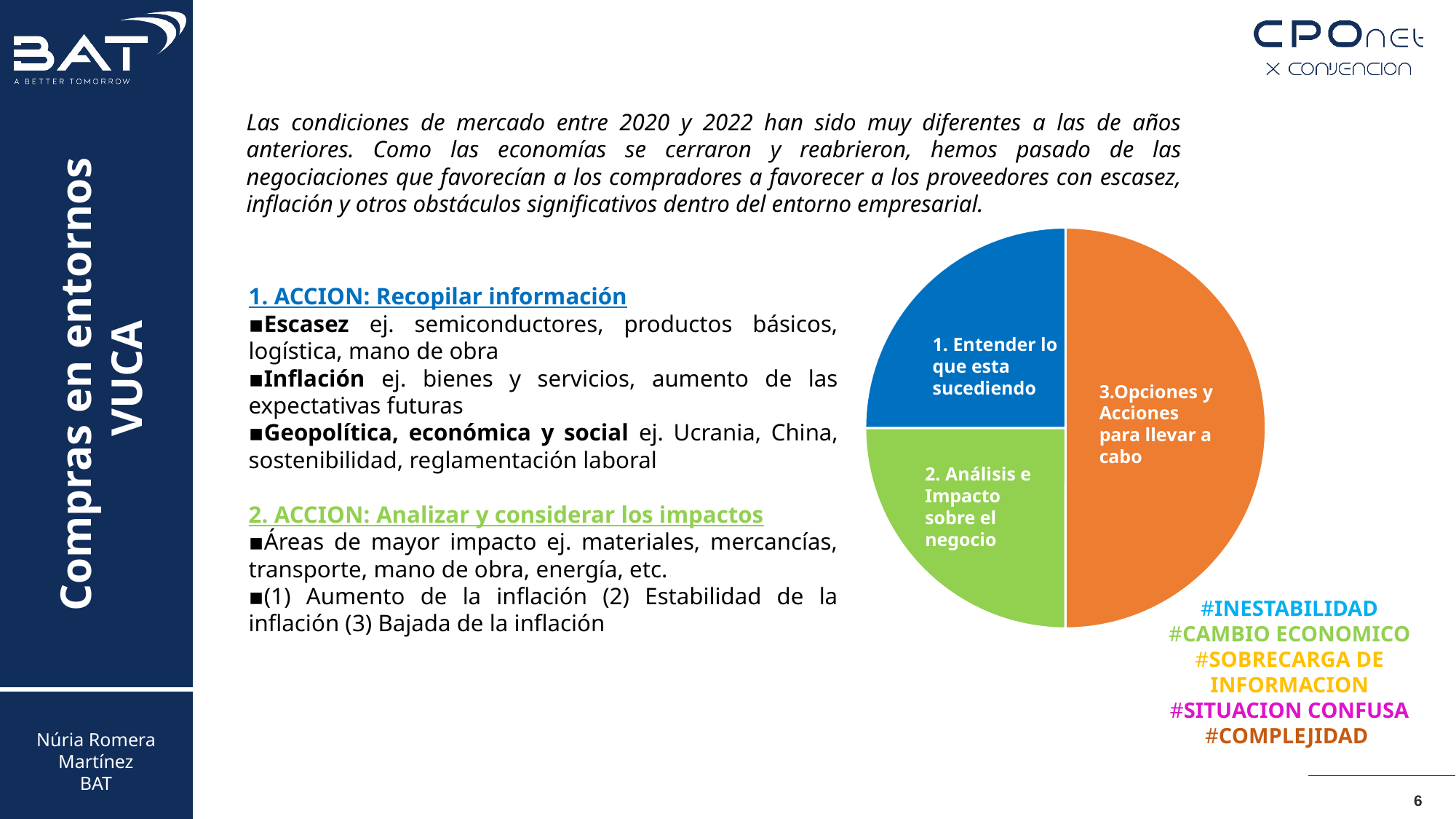
Which slice of the pie chart is the largest? 3.Opciones y Acciones para llevar a cabo What kind of chart is shown on the slide? pie chart What colour is the slice labelled '3.Opciones y Acciones para llevar a cabo' in the pie chart? orange What colour is the slice labelled '1. Entender lo que esta sucediendo' in the pie chart? blue How many slices does the pie chart have? 3 Which is larger in the pie chart: the slice for '2. Análisis e Impacto sobre el negocio' or the slice for '3.Opciones y Acciones para llevar a cabo'? 3.Opciones y Acciones para llevar a cabo Which is larger in the pie chart: the slice for '3.Opciones y Acciones para llevar a cabo' or the slice for '1. Entender lo que esta sucediendo'? 3.Opciones y Acciones para llevar a cabo